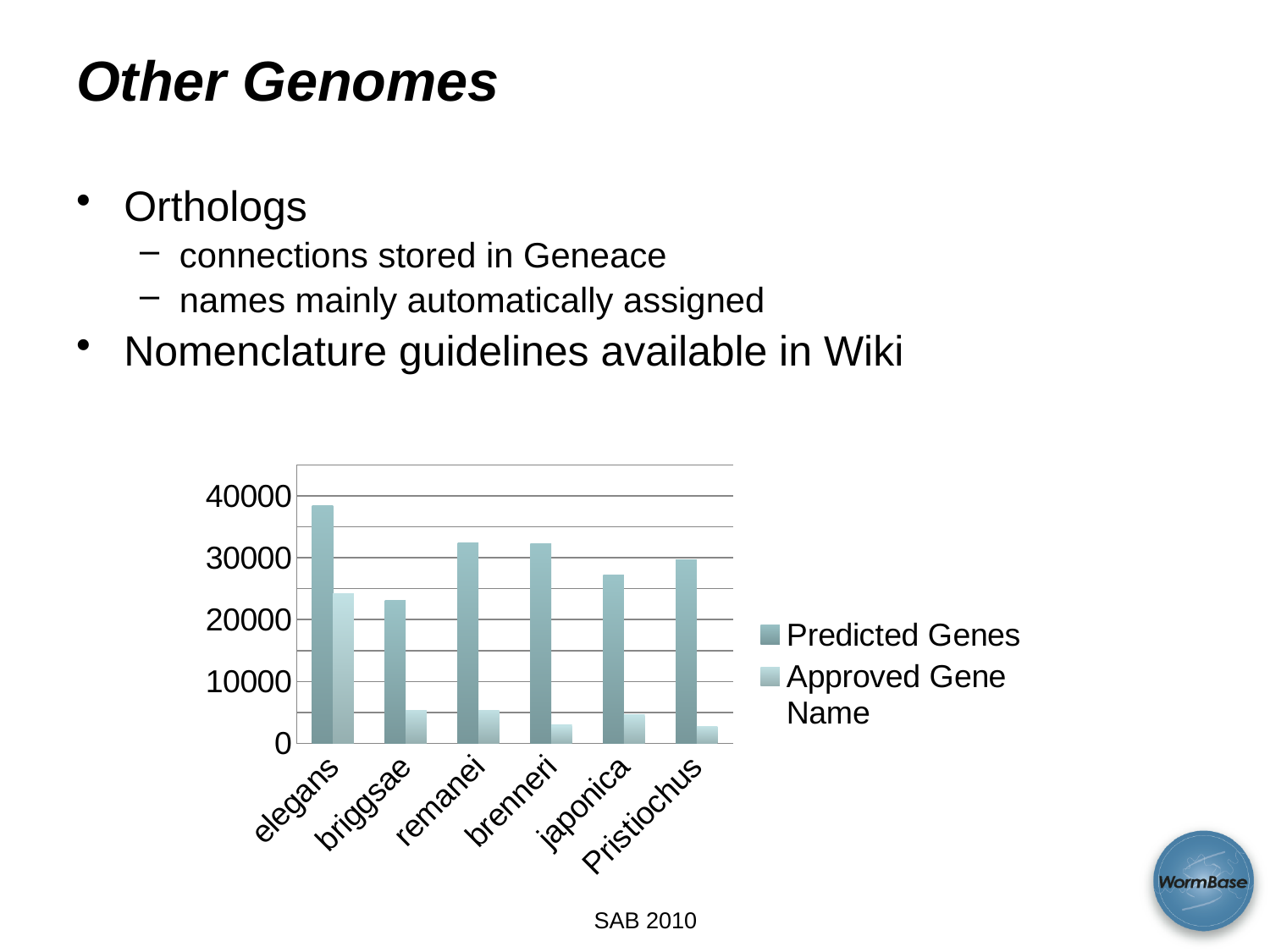
Which genome has the highest value for Approved Gene Name? elegans Is the Approved Gene Name value for Pristiochus greater or less than 10000? less Which is larger: the Approved Gene Name value for elegans or for briggsae? elegans Which genome has the lowest value for Predicted Genes? briggsae What are the two series named in the chart legend? Predicted Genes and Approved Gene Name Is the Predicted Genes value for briggsae greater or less than 20000? greater How many series does the chart legend list? 2 How many categories (genomes) are shown on the x axis of the chart? 6 Which genome has the highest value for Predicted Genes? elegans Is the Predicted Genes value for japonica greater or less than 30000? less What kind of chart is shown on the slide? bar chart